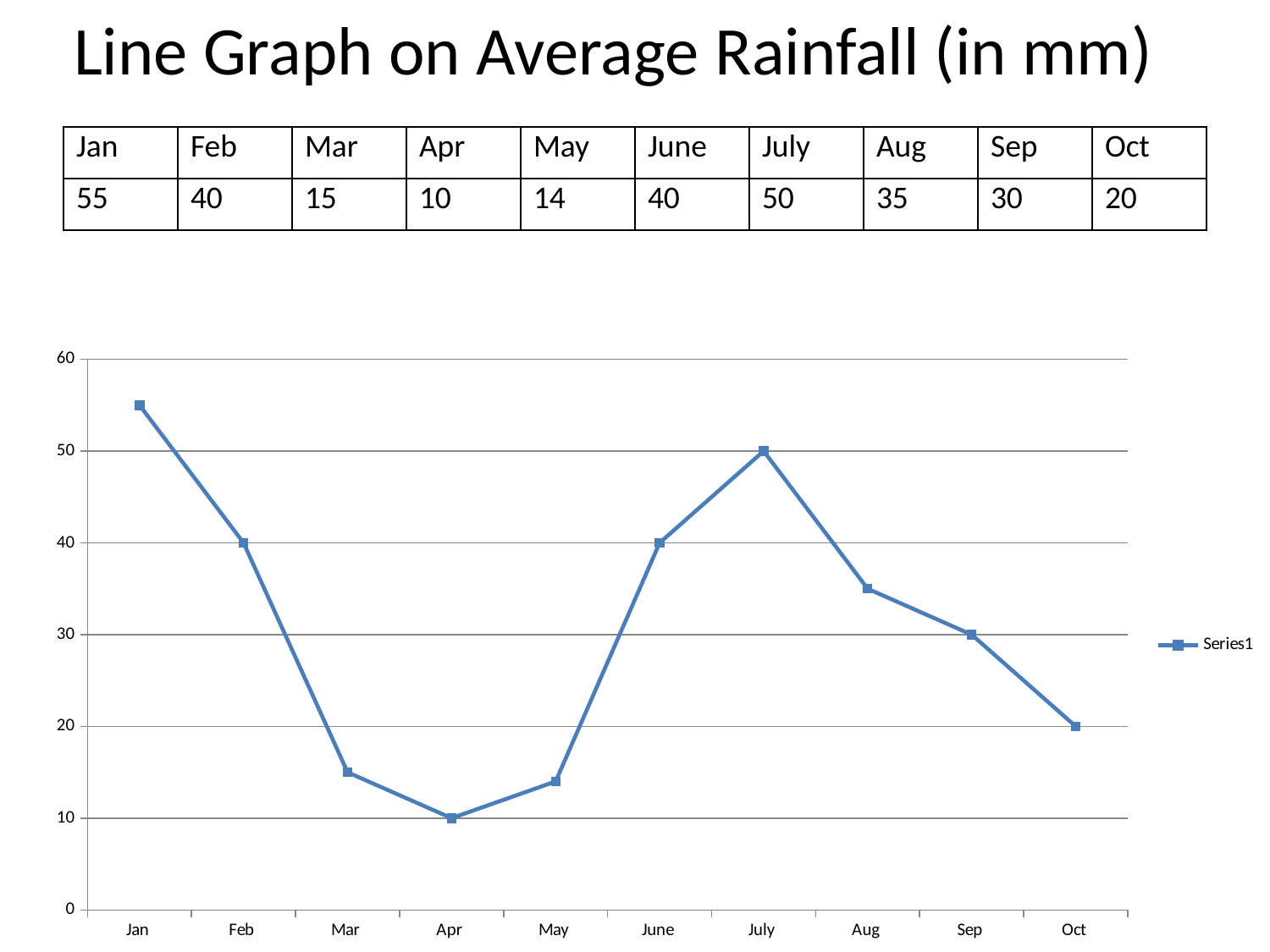
Which month has a larger rainfall value, Feb or Sep? Feb How many months are plotted on the chart? 10 Is the value for Mar greater or less than 20? less What kind of chart is shown on the slide? line chart What is the difference between the rainfall values for Jan and Oct? 35 What is the average rainfall value for July? 50 What is the difference between the rainfall values for July and Aug? 15 What is the average rainfall value for Jan? 55 Which month has the highest average rainfall? Jan Which month has the lowest average rainfall? Apr What is the average rainfall value for May? 14 Do the values rise or fall from July to Oct? fall